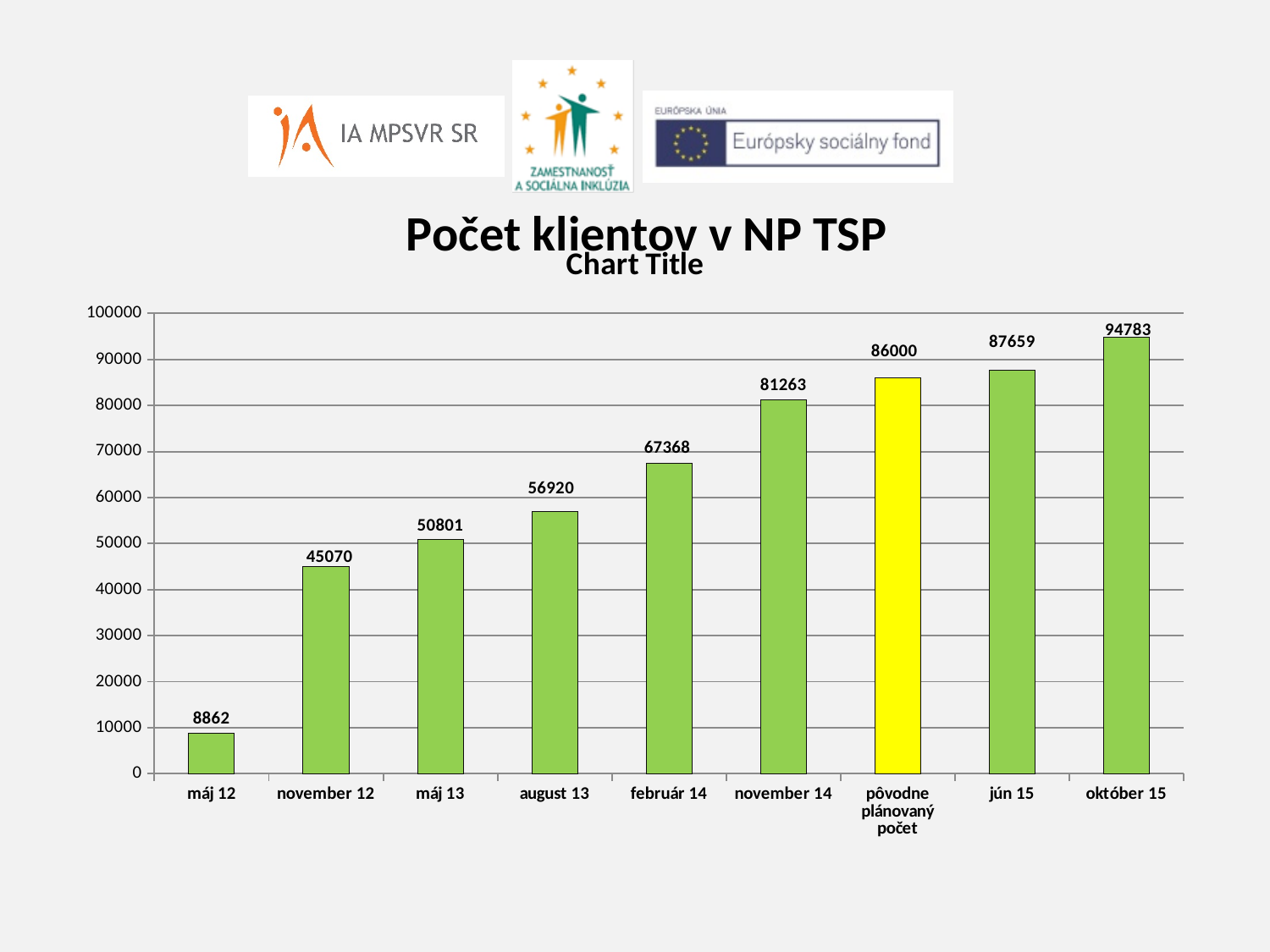
Which bar is coloured yellow instead of green? pôvodne plánovaný počet Is the value for august 13 greater or less than 50000? greater Which category has the lowest value? máj 12 What is the value for máj 12? 8862 What kind of chart is shown on the slide? bar chart Which is larger, the value for jún 15 or the value for pôvodne plánovaný počet? jún 15 Which category has the highest value? október 15 How many categories are shown on the x axis? 9 What is the value for február 14? 67368 What is the difference between the values for október 15 and jún 15? 7124 What is the difference between the values for november 12 and máj 12? 36208 What is the value for pôvodne plánovaný počet? 86000